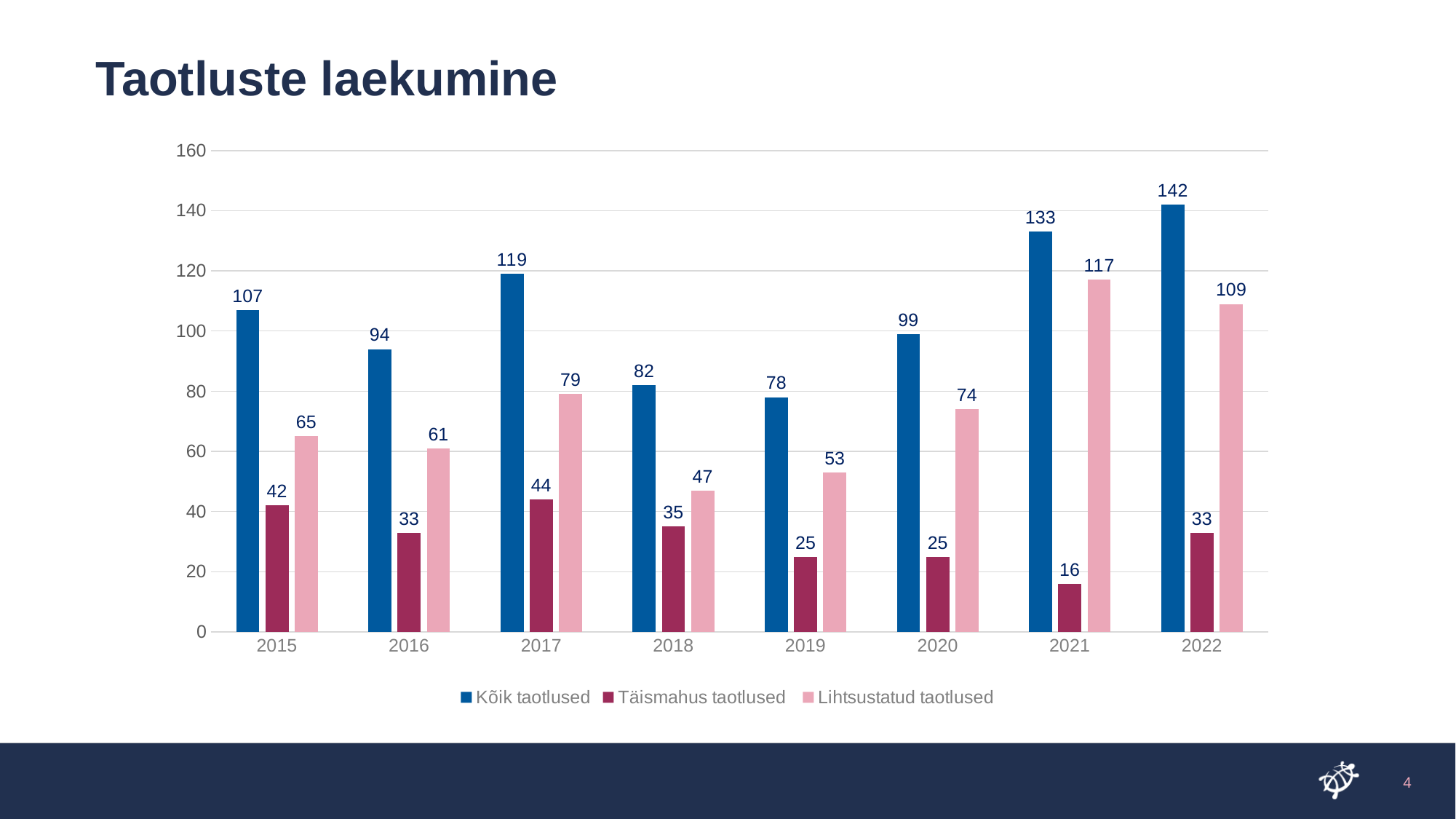
How many years are shown on the x axis? 8 In which year is Kõik taotlused highest? 2022 What is the value for Kõik taotlused in 2017? 119 What kind of chart is shown on the slide? bar chart Is the value for Kõik taotlused in 2019 greater or less than 80? less What is the title of the chart on the slide? Taotluste laekumine In which year is Täismahus taotlused lowest? 2021 Which is larger: Lihtsustatud taotlused in 2021 or in 2022? 2021 What is the difference between Kõik taotlused in 2022 and in 2021? 9 What is the value for Täismahus taotlused in 2021? 16 How many series does the legend list? 3 What is the value for Lihtsustatud taotlused in 2019? 53